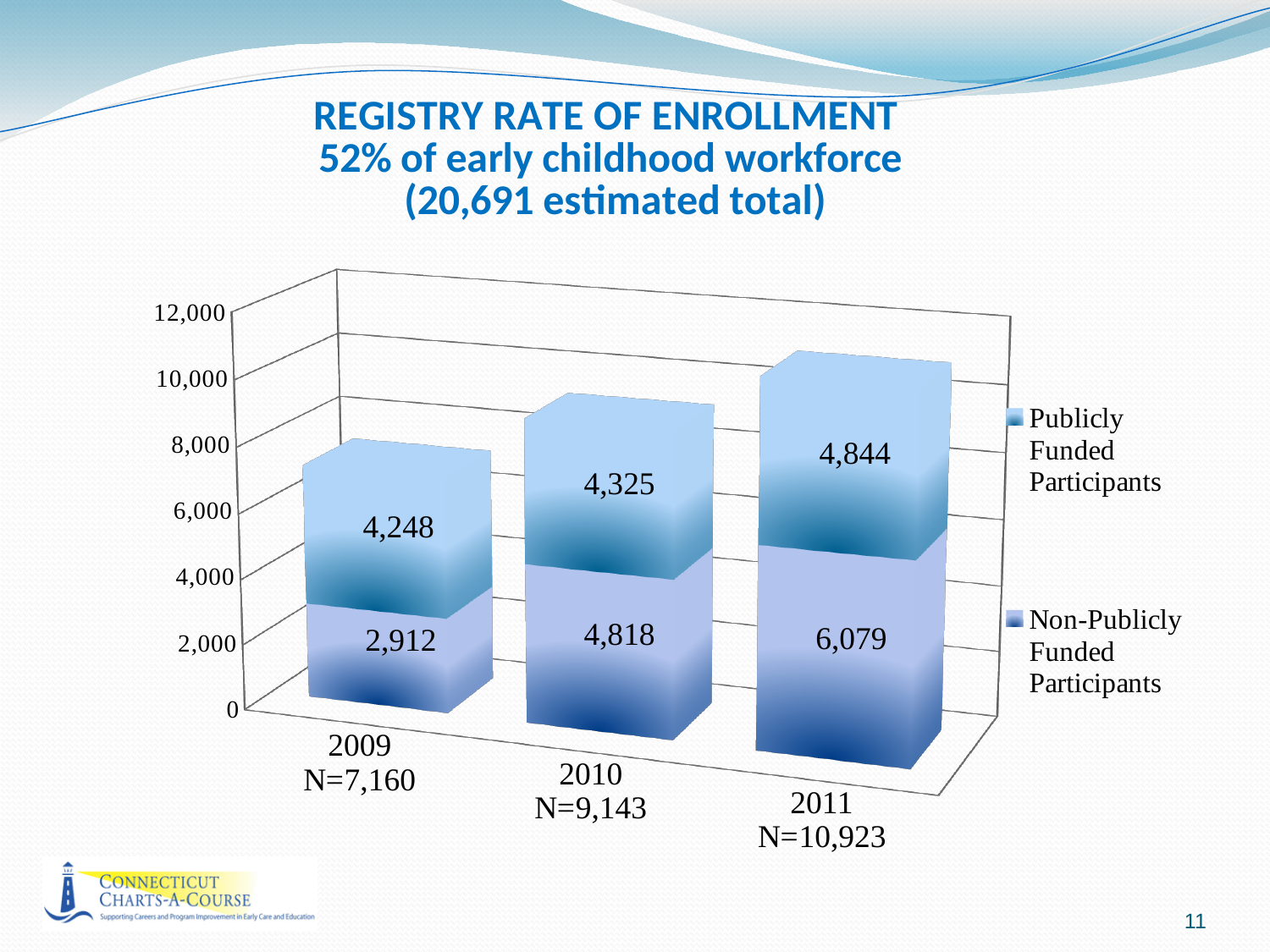
What is the total of the stacked bar for 2011? 10,923 What kind of chart is shown on the slide? Stacked bar chart What is the value for Publicly Funded Participants in 2009? 4,248 What is the value for Non-Publicly Funded Participants in 2010? 4,818 Which year has the lowest value for Publicly Funded Participants? 2009 Which year has the highest value for Non-Publicly Funded Participants? 2011 How many years are shown on the x axis? 3 How many series does the legend list? 2 What is the value for Non-Publicly Funded Participants in 2011? 6,079 Which is larger in 2010: Publicly Funded Participants or Non-Publicly Funded Participants? Non-Publicly Funded Participants Do the total enrollment values rise or fall from 2009 to 2011? Rise What is the difference between Non-Publicly Funded Participants in 2011 and 2009? 3,167